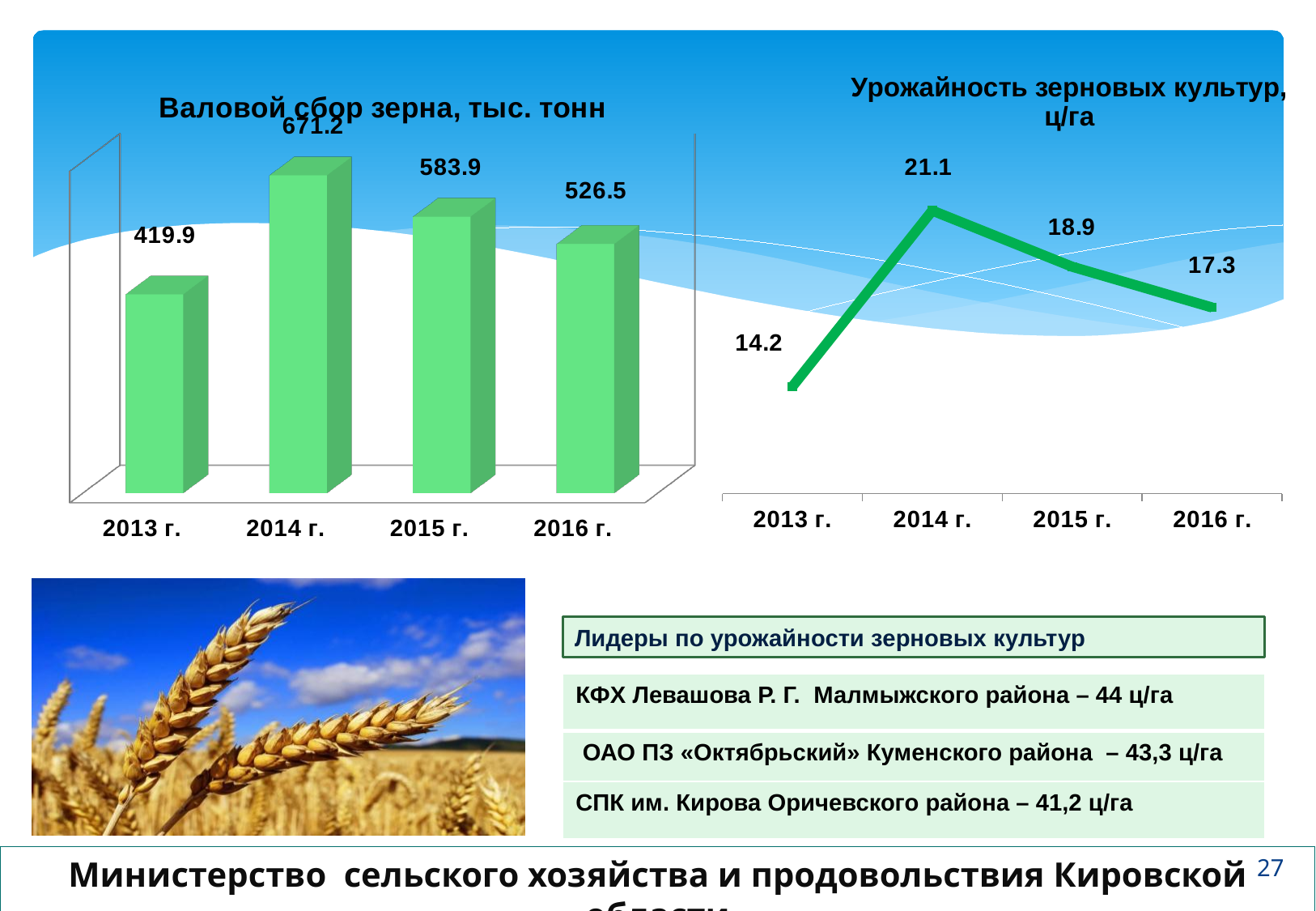
In the chart 'Валовой сбор зерна, тыс. тонн', what is the difference between the values for 2014 г. and 2013 г.? 251.3 In the chart 'Валовой сбор зерна, тыс. тонн', which year has the lowest value? 2013 г. In the chart 'Валовой сбор зерна, тыс. тонн', how many years are shown? 4 In the chart 'Урожайность зерновых культур, ц/га', what is the value for 2015 г.? 18.9 In the chart 'Урожайность зерновых культур, ц/га', what kind of chart is shown? line chart In the chart 'Валовой сбор зерна, тыс. тонн', what kind of chart is shown? bar chart In the chart 'Валовой сбор зерна, тыс. тонн', which year has the highest value? 2014 г. In the chart 'Валовой сбор зерна, тыс. тонн', what is the value for 2016 г.? 526.5 In the chart 'Урожайность зерновых культур, ц/га', what is the value for 2013 г.? 14.2 In the chart 'Урожайность зерновых культур, ц/га', which year has the highest value? 2014 г. In the chart 'Урожайность зерновых культур, ц/га', what is the difference between the values for 2014 г. and 2016 г.? 3.8 In the chart 'Валовой сбор зерна, тыс. тонн', what is the value for 2014 г.? 671.2